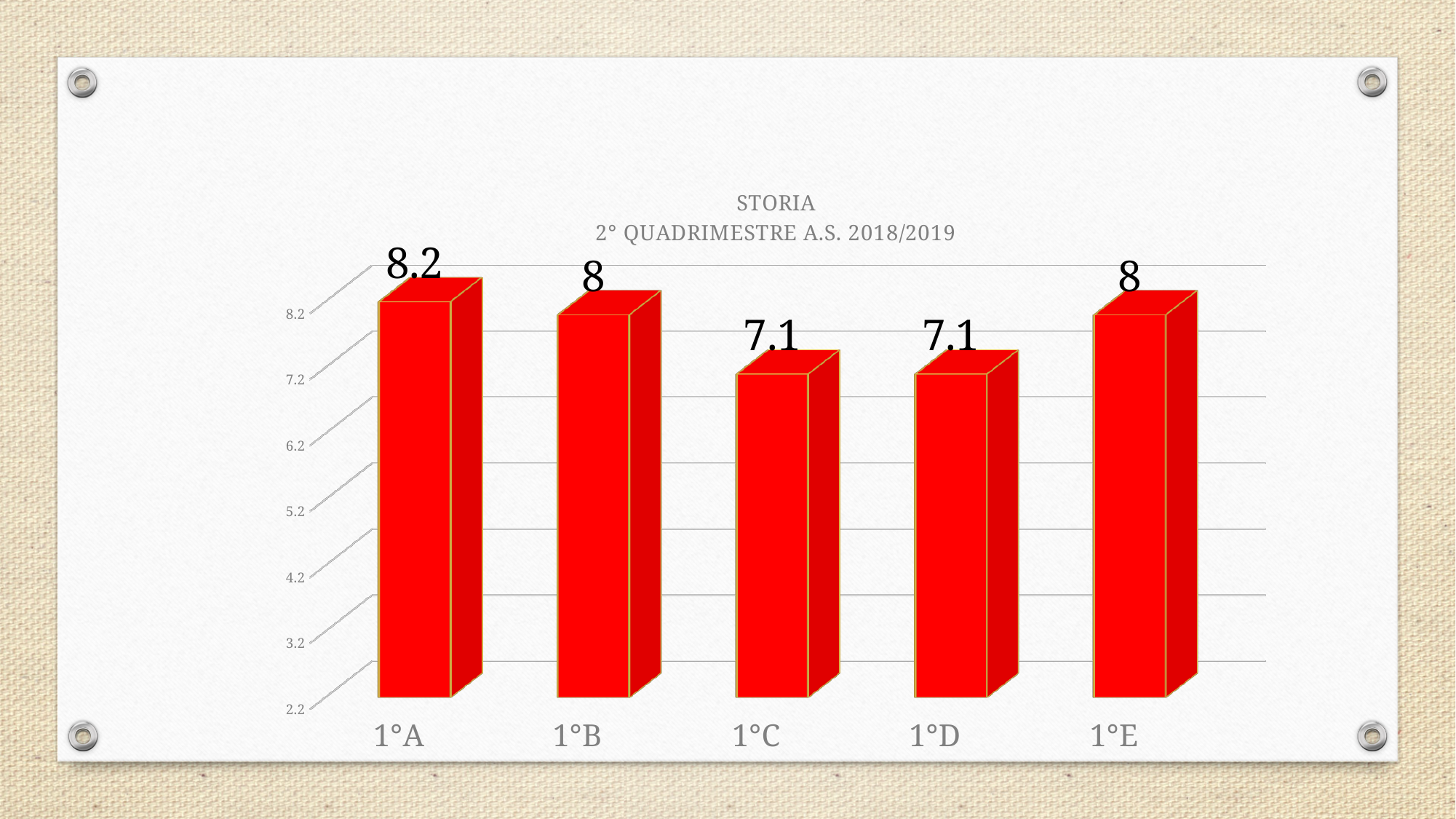
What is the value for 1°C? 7.1 Which class has the highest value? 1°A What is the value for 1°E? 8 What kind of chart is shown on the slide? bar chart How many classes are shown on the x axis? 5 What is the difference between the values for 1°A and 1°C? 1.1 What is the value for 1°A? 8.2 What colour are the bars in the chart? red What is the difference between the values for 1°B and 1°D? 0.9 Which is larger, the value for 1°A or the value for 1°B? 1°A What is the title of the chart? STORIA 2° QUADRIMESTRE A.S. 2018/2019 Is the value for 1°D greater or less than 6.2? greater